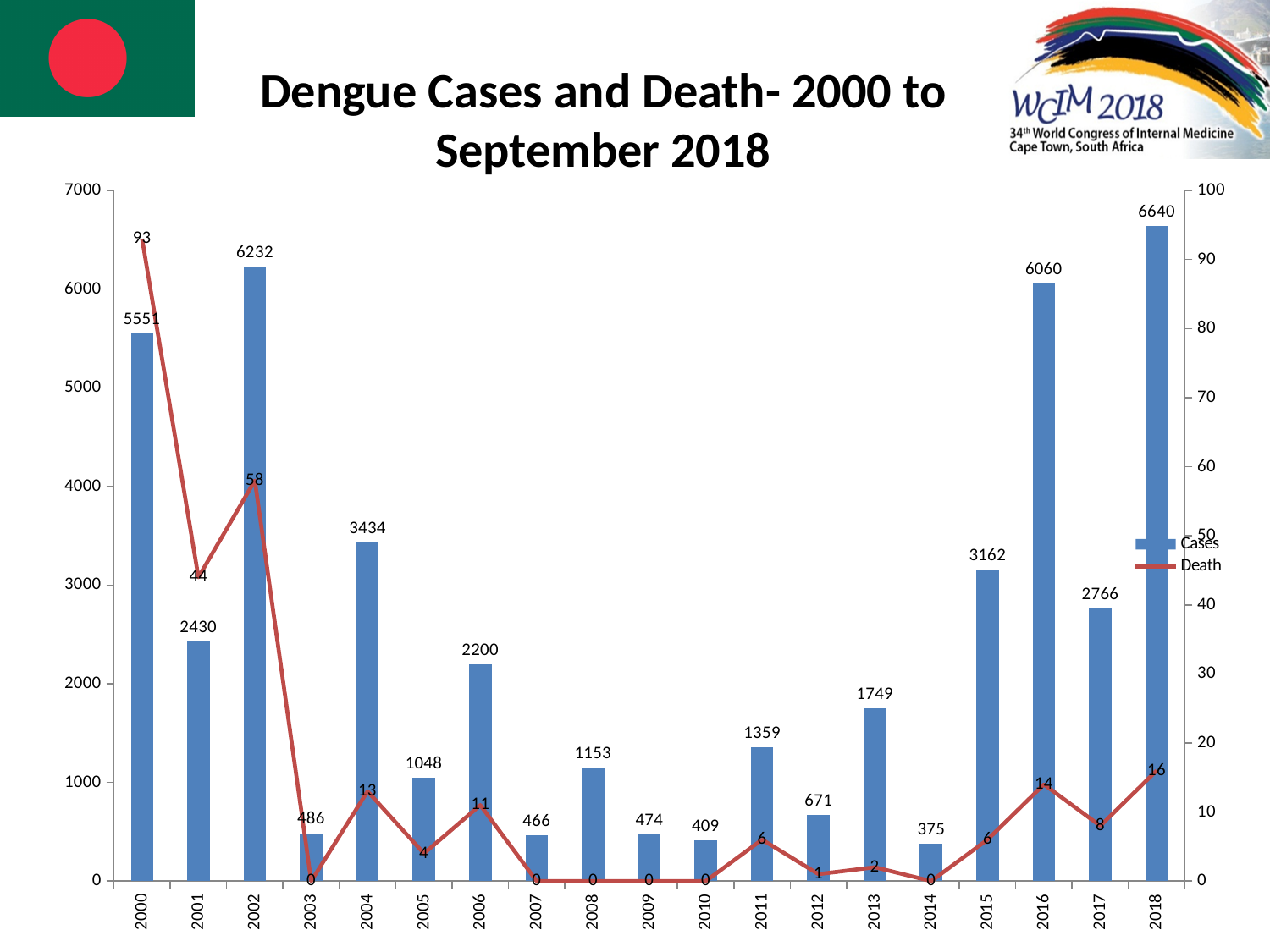
What is the difference in cases between 2002 and 2001? 3802 How many dengue cases are shown for 2018? 6640 Do the dengue cases rise or fall from 2014 to 2016? Rise Which year has the lowest number of dengue cases? 2014 What kind of chart is used to show the Cases series? Bar chart How many deaths are shown for 2000? 93 Which year has the highest number of dengue cases? 2018 How many series does the legend list? 2 What is the title of the chart? Dengue Cases and Death- 2000 to September 2018 Which year had more cases, 2016 or 2015? 2016 How many deaths are shown for 2016? 14 How many years are shown on the x axis? 19